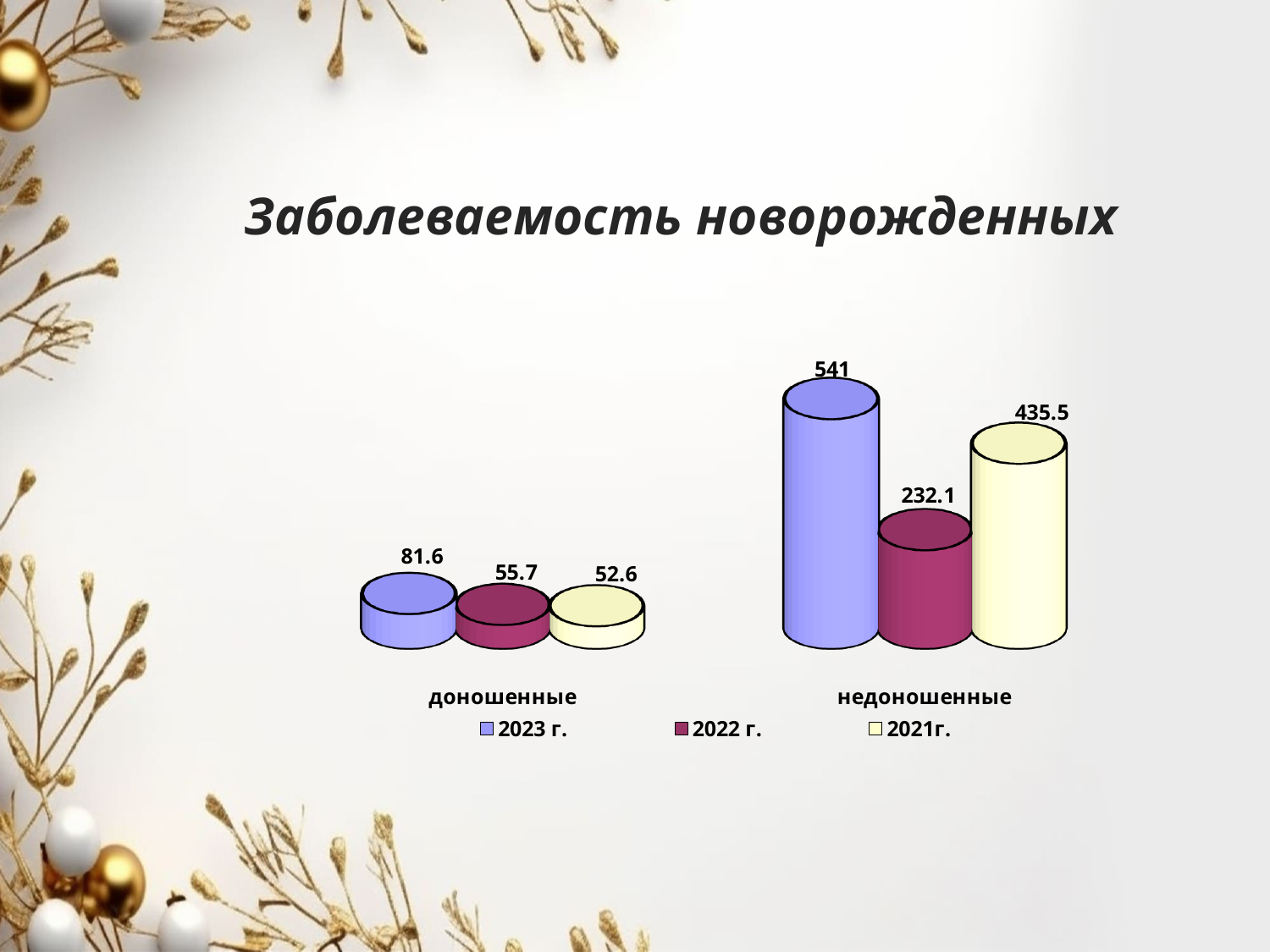
What is the difference between the 2023 г. and 2022 г. values for недоношенные? 308.9 What is the difference between the 2023 г. and 2022 г. values for доношенные? 25.9 What kind of chart is shown on the slide? Bar chart What is the value for доношенные in 2021г.? 52.6 Which series has the highest value for недоношенные? 2023 г. Which is larger: the 2021г. value for недоношенные or the 2022 г. value for недоношенные? 2021г. What is the value for недоношенные in 2022 г.? 232.1 How many series does the legend list? 3 How many categories are shown on the x axis? 2 What is the value for недоношенные in 2021г.? 435.5 Which series has the lowest value for доношенные? 2021г. What is the value for доношенные in 2023 г.? 81.6